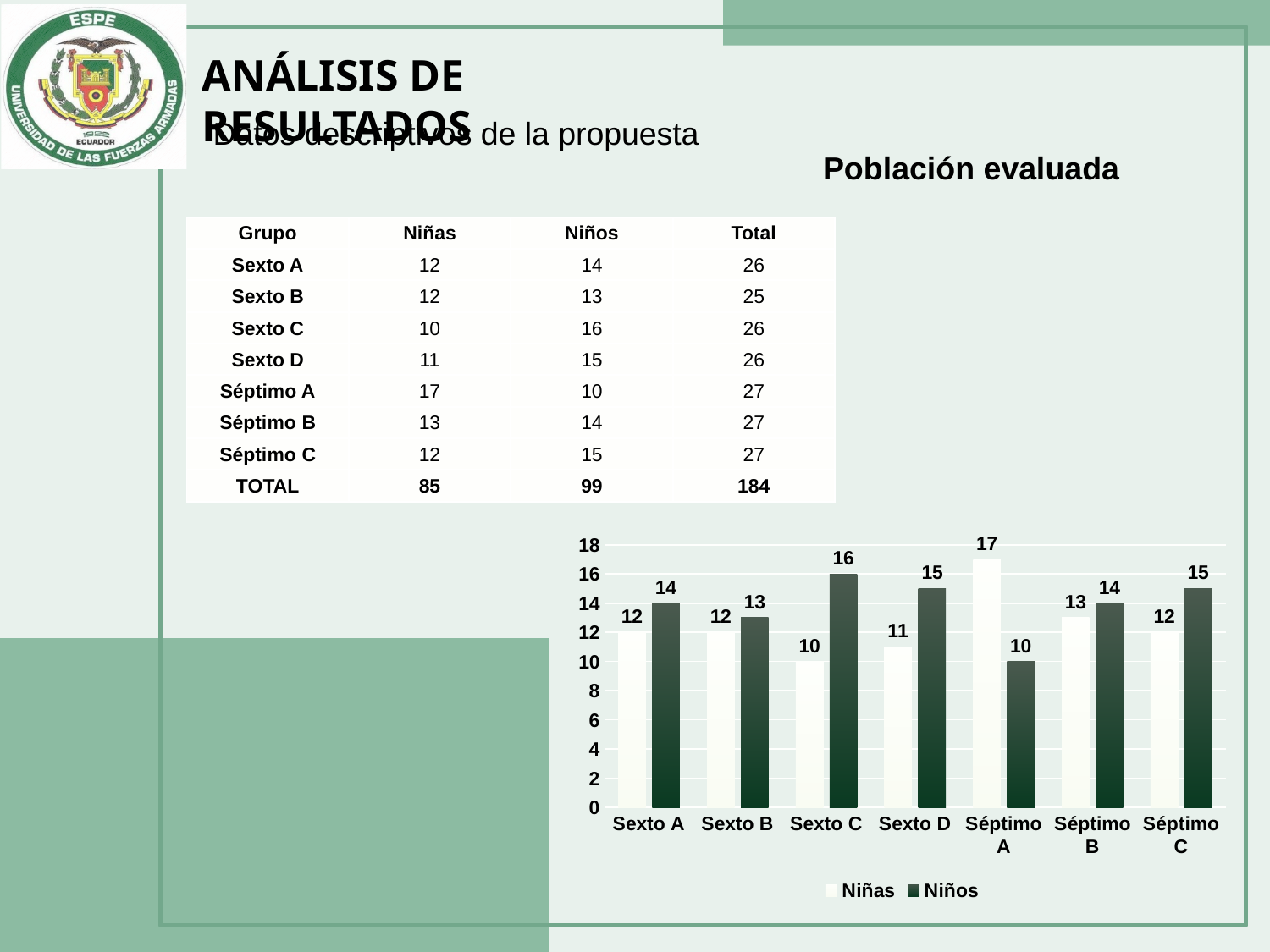
Which group has the highest value for Niños? Sexto C What is the value for Niñas in Séptimo B? 13 Which group has the lowest value for Niñas? Sexto C What is the value for Niñas in Séptimo A? 17 What is the difference between Niños and Niñas in Sexto C? 6 Which is larger in Séptimo A, Niñas or Niños? Niñas Is the value for Niños in Sexto D greater or less than 12? greater How many series does the chart legend list? 2 What is the value for Niños in Sexto C? 16 What kind of chart is shown on the slide? bar chart What are the two series listed in the chart legend? Niñas and Niños How many groups are shown on the x axis of the chart? 7